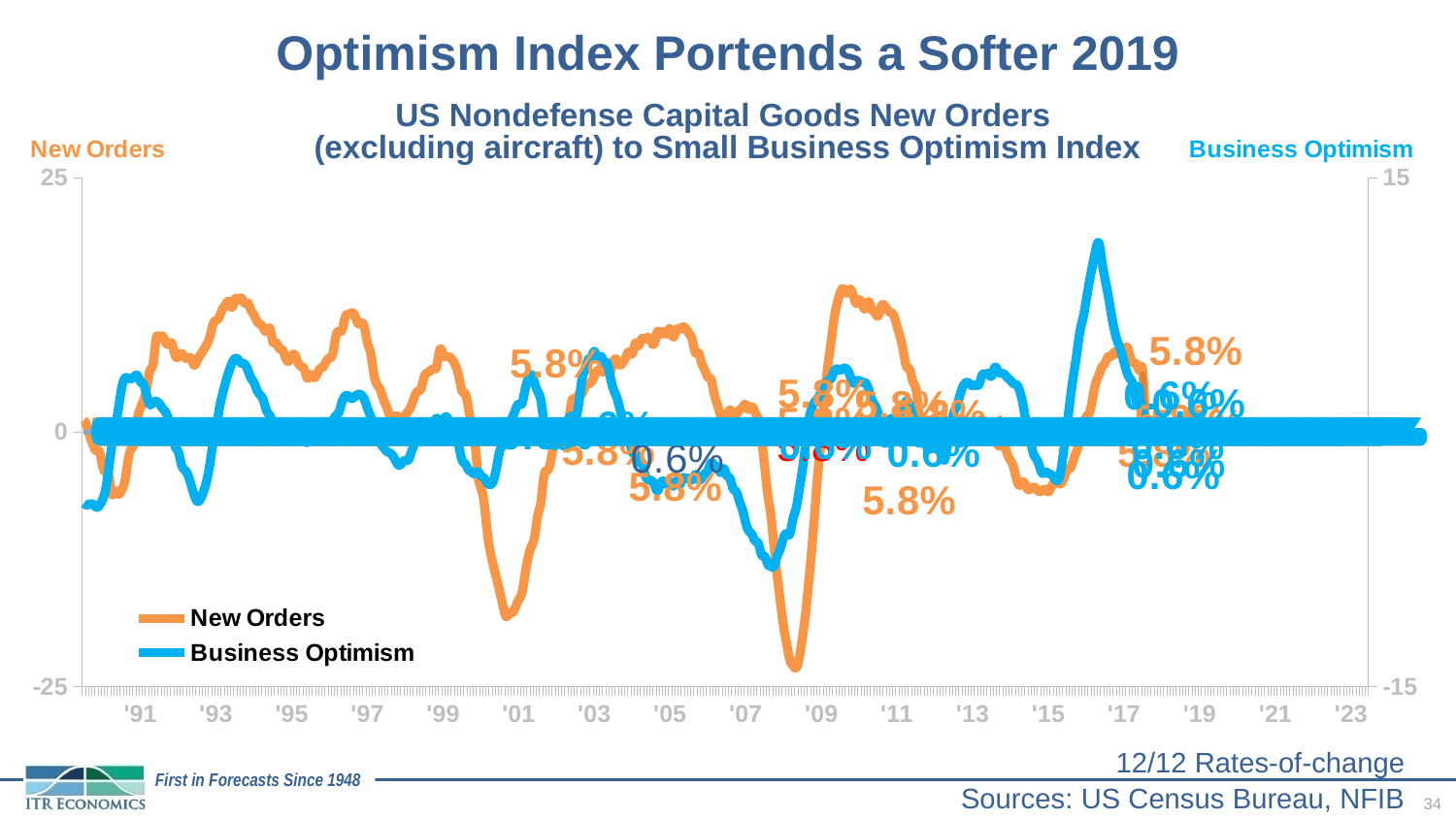
What are the two series named in the legend? New Orders and Business Optimism Is the peak value of the Business Optimism series around '17 greater or less than 15 on the right axis? less What kind of chart is shown on the slide? line chart What is the title of the chart? US Nondefense Capital Goods New Orders (excluding aircraft) to Small Business Optimism Index How many series does the legend list? 2 Is the value of the New Orders series around '10 greater or less than 0? greater Around '08, which series has the lower value: New Orders or Business Optimism? New Orders Is the value of the New Orders series around '01 greater or less than 0? less